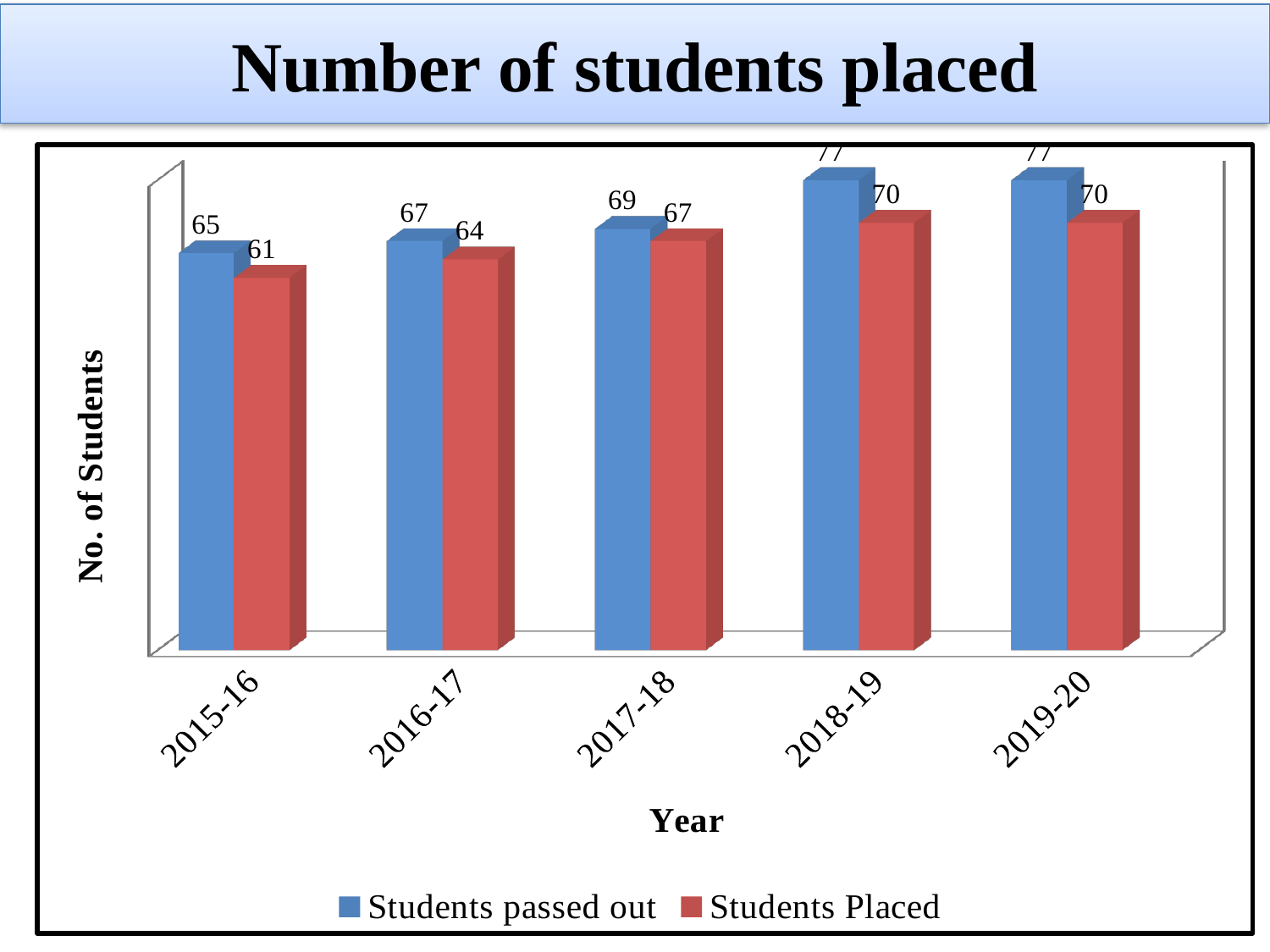
How many students were placed in 2015-16? 61 What is the value for Students passed out in 2016-17? 67 How many years are shown on the x axis? 5 How many series does the legend list? 2 What is the difference between Students Placed in 2017-18 and in 2016-17? 3 What is the difference between Students passed out and Students Placed in 2015-16? 4 What kind of chart is shown on the slide? Bar chart Which year has the lowest number of Students Placed? 2015-16 How many students passed out in 2017-18? 69 Which year has the lowest number of Students passed out? 2015-16 Which is larger in 2017-18: Students passed out or Students Placed? Students passed out What is the value for Students Placed in 2016-17? 64